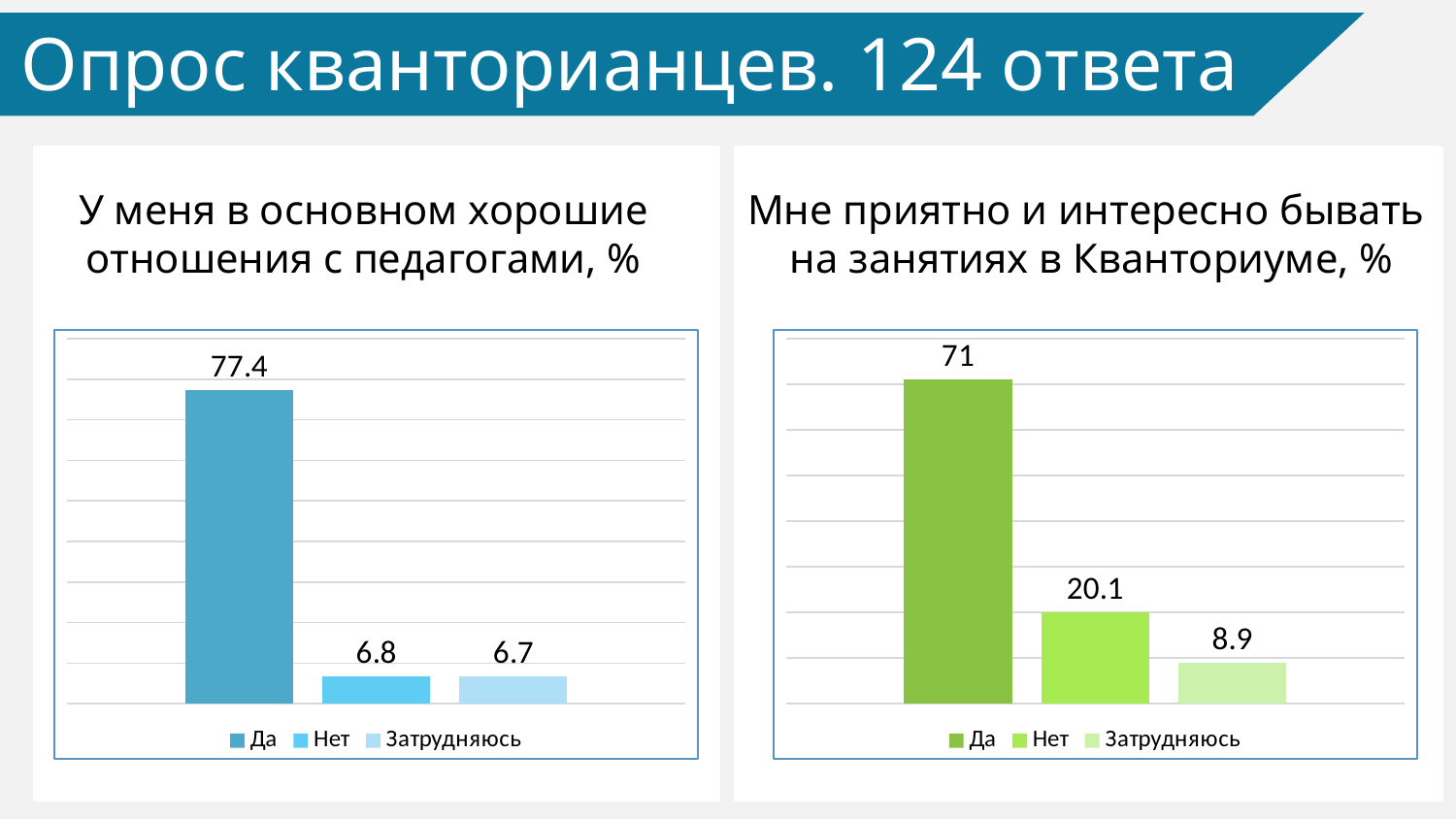
In the left chart (У меня в основном хорошие отношения с педагогами), what is the value for Нет? 6.8 In the left chart (У меня в основном хорошие отношения с педагогами), which category has the highest value? Да In the right chart (Мне приятно и интересно бывать на занятиях в Кванториуме), what is the value for Да? 71 How many categories does the left chart (У меня в основном хорошие отношения с педагогами) show? 3 In the right chart (Мне приятно и интересно бывать на занятиях в Кванториуме), which category has the lowest value? Затрудняюсь In the right chart (Мне приятно и интересно бывать на занятиях в Кванториуме), which is larger, the value for Нет or the value for Затрудняюсь? Нет In the right chart (Мне приятно и интересно бывать на занятиях в Кванториуме), what is the value for Затрудняюсь? 8.9 In the left chart (У меня в основном хорошие отношения с педагогами), what is the value for Да? 77.4 In the left chart (У меня в основном хорошие отношения с педагогами), what is the difference between the values for Нет and Затрудняюсь? 0.1 What type of chart is the right chart (Мне приятно и интересно бывать на занятиях в Кванториуме)? Bar chart In the right chart (Мне приятно и интересно бывать на занятиях в Кванториуме), what is the difference between the values for Да and Нет? 50.9 What entries does the legend of the right chart (Мне приятно и интересно бывать на занятиях в Кванториуме) list? Да, Нет, Затрудняюсь